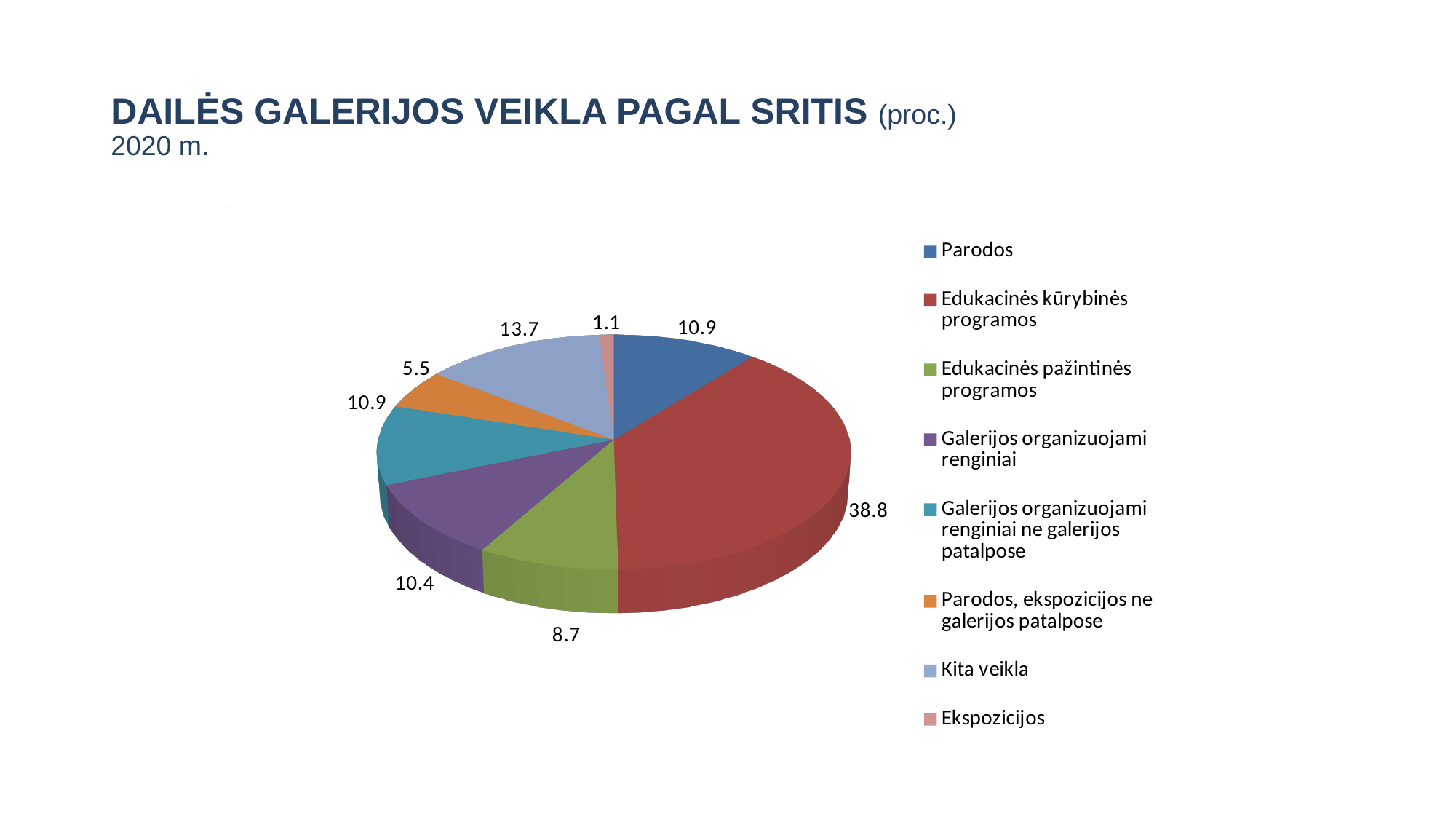
Which is larger, the value for Edukacinės pažintinės programos or the value for Galerijos organizuojami renginiai? Galerijos organizuojami renginiai What is the difference between the values for Edukacinės kūrybinės programos and Kita veikla? 25.1 What kind of chart is shown on the slide? pie chart What is the value for Kita veikla? 13.7 Which category has the largest share of the pie? Edukacinės kūrybinės programos How many categories does the pie chart have? 8 What is the title of the chart on the slide? DAILĖS GALERIJOS VEIKLA PAGAL SRITIS (proc.) 2020 m. Which category is shown in orange in the legend? Parodos, ekspozicijos ne galerijos patalpose What is the value for Galerijos organizuojami renginiai? 10.4 What is the value for Parodos, ekspozicijos ne galerijos patalpose? 5.5 Which category has the smallest share of the pie? Ekspozicijos What is the value for Edukacinės kūrybinės programos? 38.8